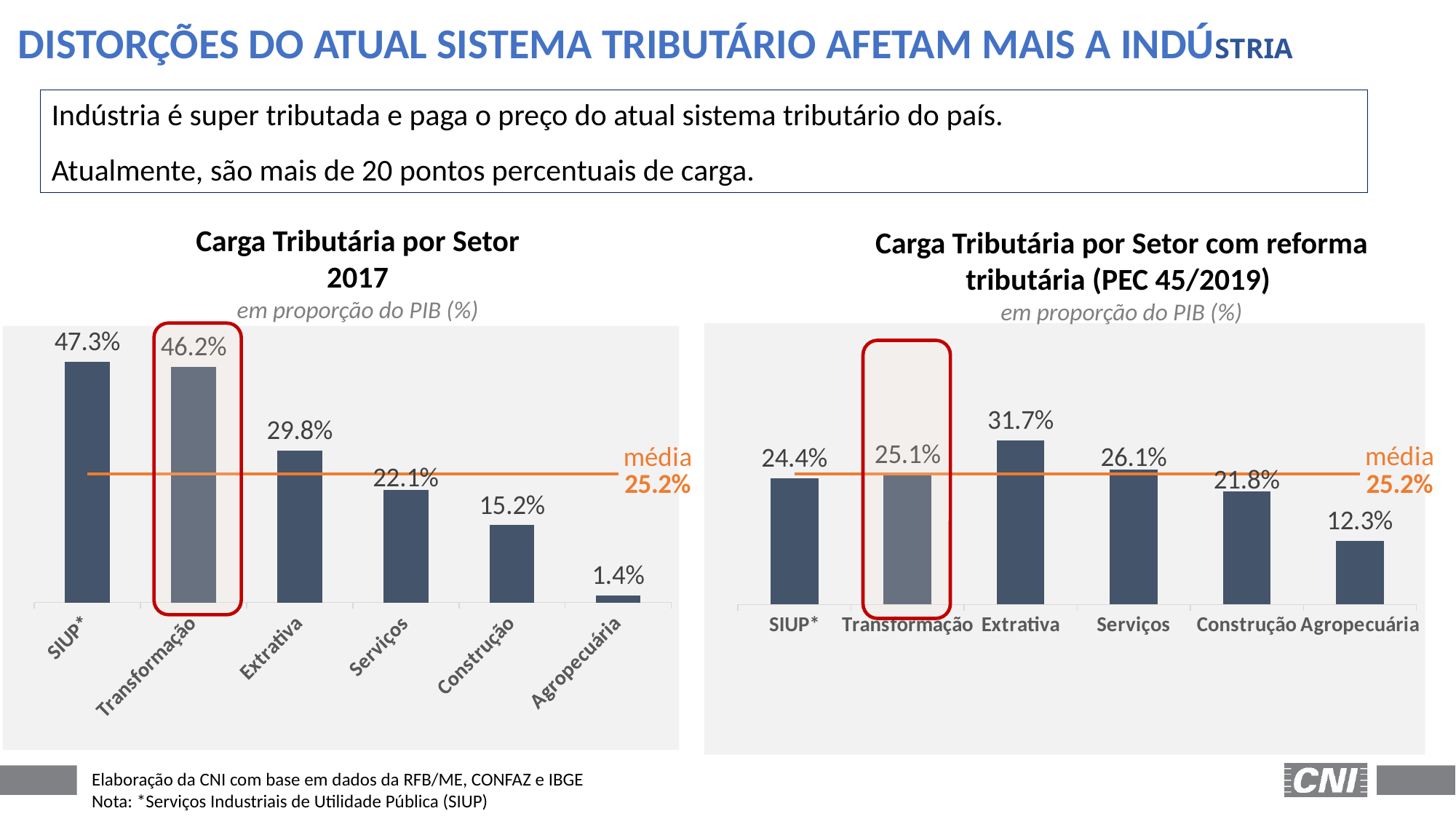
What is the value of the média line shown in the right chart (Carga Tributária por Setor com reforma tributária)? 25.2% How many sectors are shown in the left chart (Carga Tributária por Setor 2017)? 6 What type of chart is the left chart (Carga Tributária por Setor 2017)? Bar chart In the right chart (Carga Tributária por Setor com reforma tributária), what is the difference between Extrativa and Agropecuária? 19.4 percentage points In the right chart (Carga Tributária por Setor com reforma tributária), which is larger, Serviços or Construção? Serviços In the left chart (Carga Tributária por Setor 2017), what is the value for Transformação? 46.2% In the left chart (Carga Tributária por Setor 2017), what is the difference between SIUP* and Serviços? 25.2 percentage points In the left chart (Carga Tributária por Setor 2017), which sector has the lowest value? Agropecuária In the right chart (Carga Tributária por Setor com reforma tributária), what is the value for Extrativa? 31.7% In the right chart (Carga Tributária por Setor com reforma tributária), which sector has the highest value? Extrativa In the left chart (Carga Tributária por Setor 2017), which sector has the highest value? SIUP* In the right chart (Carga Tributária por Setor com reforma tributária), which sector has the lowest value? Agropecuária